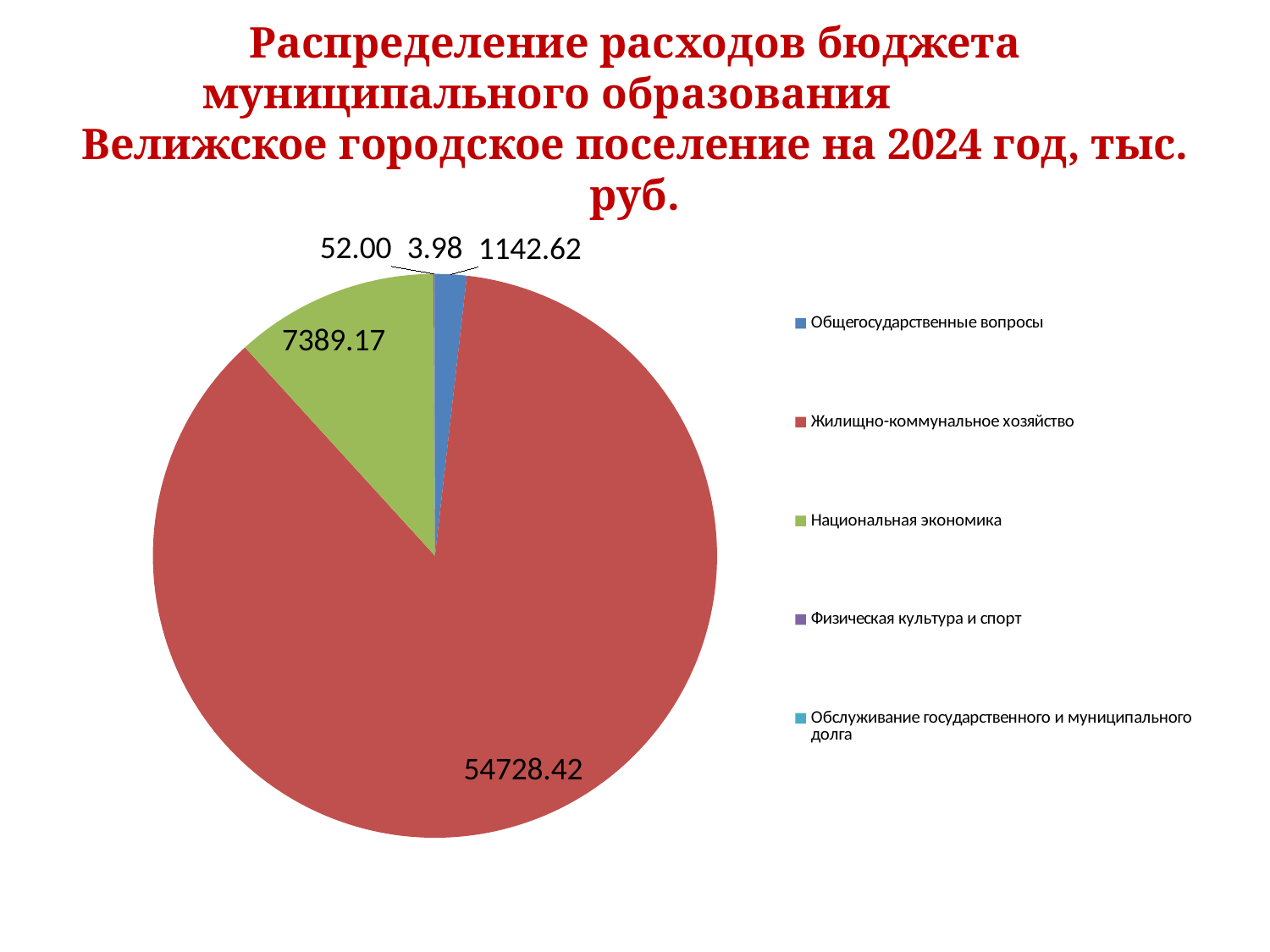
What is the sum of all five values labelled on the chart? 63316.19 What colour is the slice for Национальная экономика? green What is the value for Общегосударственные вопросы? 1142.62 How many categories does the legend list? 5 What is the value for Жилищно-коммунальное хозяйство? 54728.42 What is the difference between the values for Национальная экономика and Общегосударственные вопросы? 6246.55 What is the difference between the values for Жилищно-коммунальное хозяйство and Национальная экономика? 47339.25 Which category has the largest slice of the pie? Жилищно-коммунальное хозяйство What is the value for Национальная экономика? 7389.17 Which is larger, Национальная экономика or Общегосударственные вопросы? Национальная экономика What is the smallest value labelled on the chart? 3.98 What kind of chart is shown on the slide? pie chart